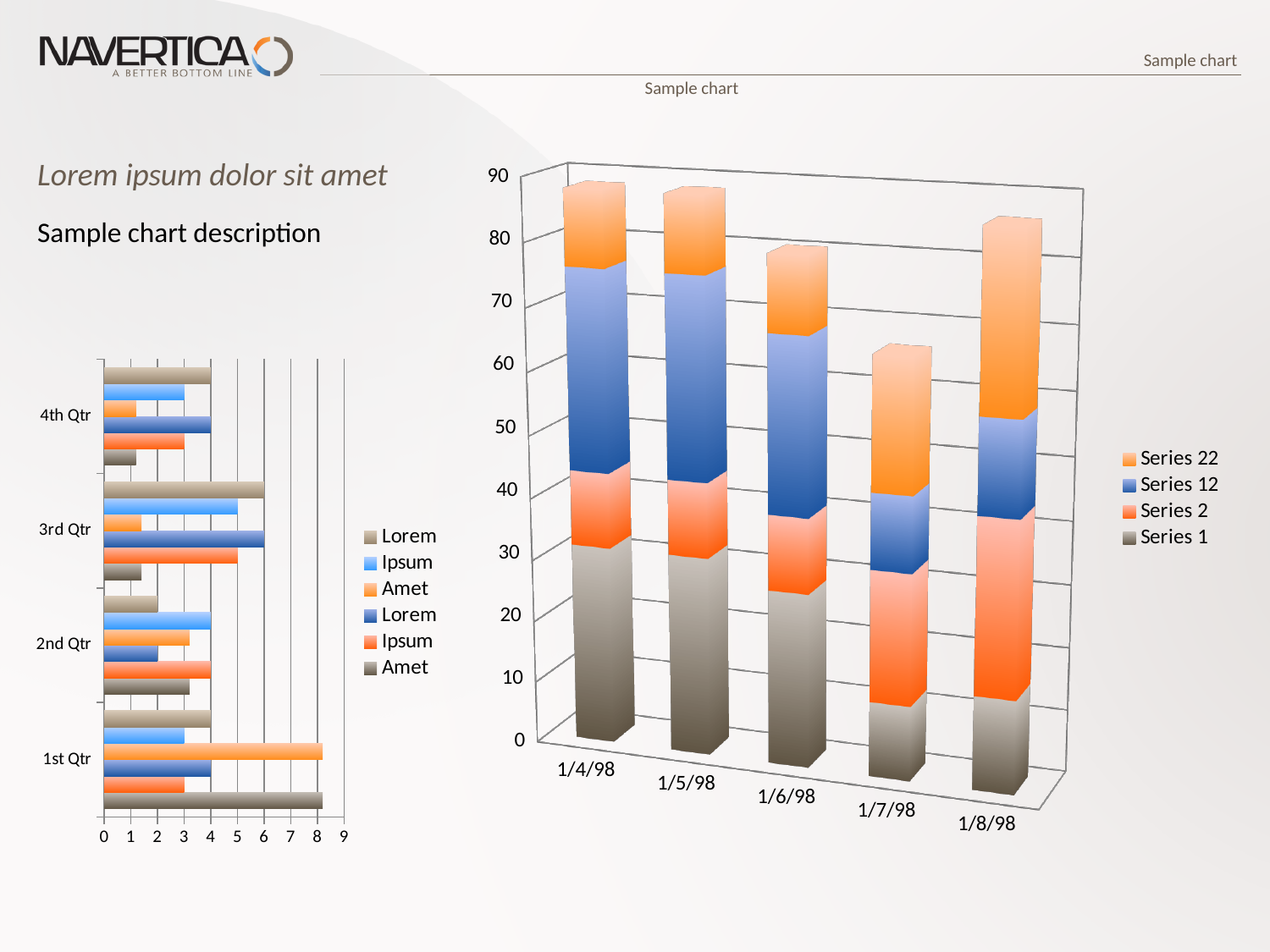
How many quarter categories does the chart on the left show? 4 How many series does the legend of the chart on the left list? 6 In the chart on the right, is the total stacked value for 1/7/98 greater or less than 70? less In the chart on the right, which date has the lowest total stacked bar? 1/7/98 What kind of chart is the chart on the left side of the slide? bar chart In the chart on the right, which has the larger total stacked bar, 1/8/98 or 1/7/98? 1/8/98 In the chart on the left, which quarter contains the longest bar? 1st Qtr In the chart on the right, which series is listed first in the legend? Series 22 In the chart on the right, is the total stacked value for 1/4/98 greater or less than 80? greater How many series does the legend of the chart on the right list? 4 What kind of chart is the chart on the right side of the slide? stacked bar chart How many date categories does the chart on the right show? 5